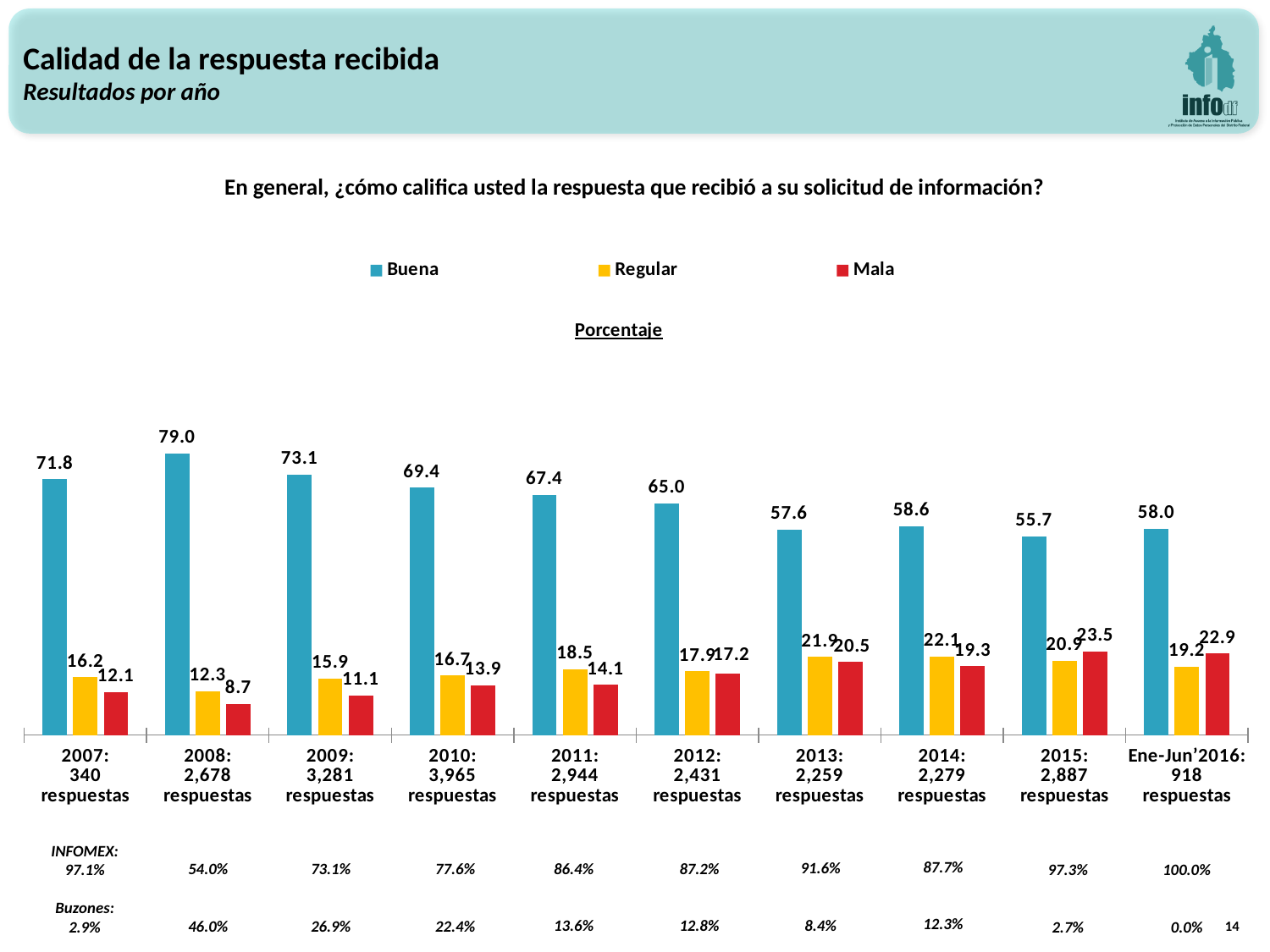
In which year is the Mala value lowest? 2008 Which is larger in 2013, Regular or Mala? Regular What is the value for Mala in 2015? 23.5 What is the difference between the Buena values for 2007 and 2015? 16.1 Does the Mala series generally rise or fall from 2008 to 2015? rise How many year categories are shown on the x axis? 10 What is the value for Regular in 2014? 22.1 Which colour represents the Regular series? yellow What is the value for Buena in 2008? 79.0 What kind of chart is shown? bar chart How many series does the legend list? 3 In which year is the Buena value highest? 2008